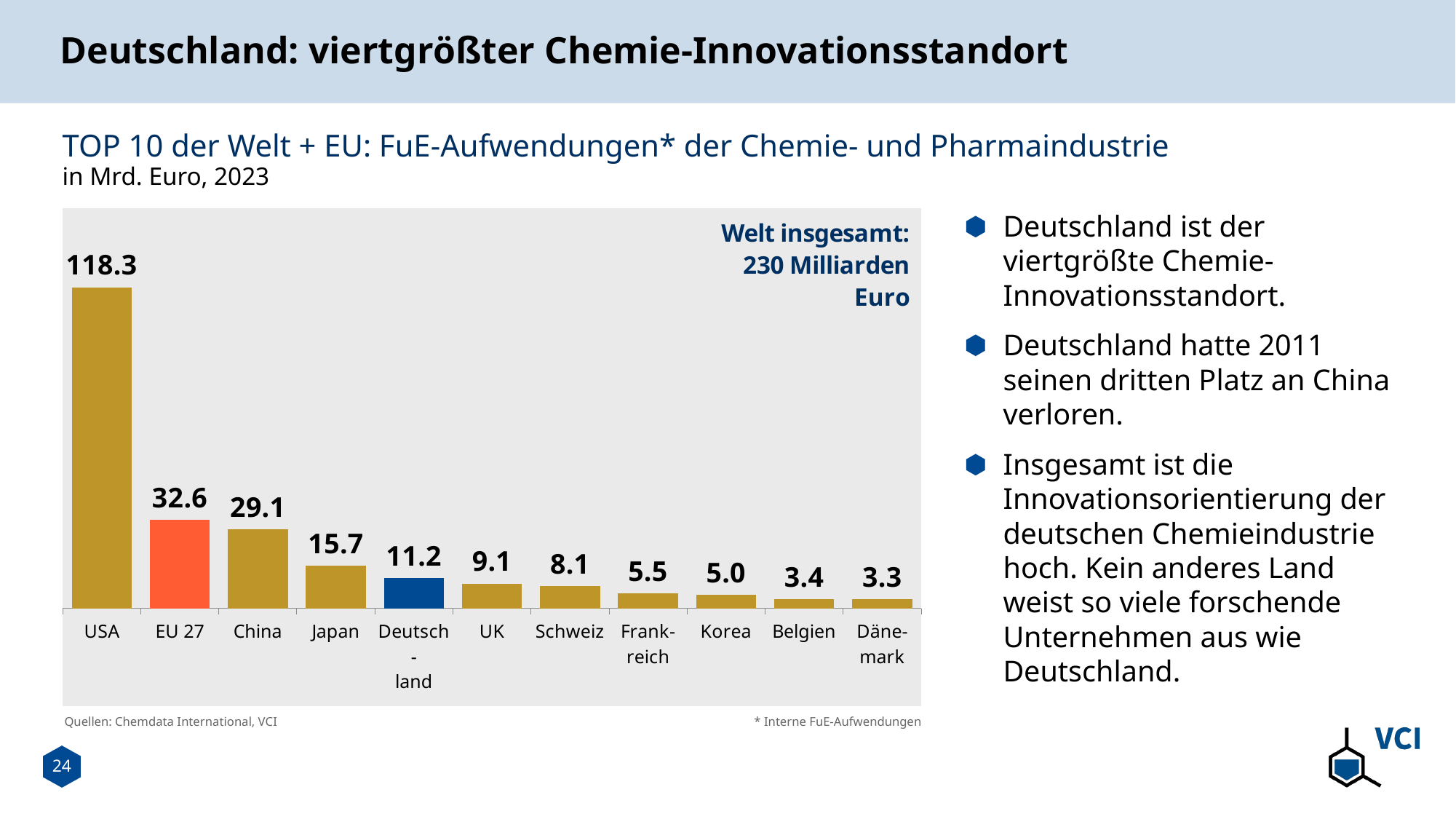
What is the difference between the values for Japan and Deutschland? 4.5 Which bar is coloured blue? Deutschland What is the value shown for the USA? 118.3 Which category has the highest value? USA What is the value shown for Deutschland? 11.2 What kind of chart is shown on the slide? bar chart What is the value shown for Schweiz? 8.1 How many categories are shown on the x axis? 11 Which is larger, the value for UK or the value for Korea? UK Which category has the lowest value? Dänemark What is the difference between the values for EU 27 and China? 3.5 What world total is stated in the chart? 230 Milliarden Euro